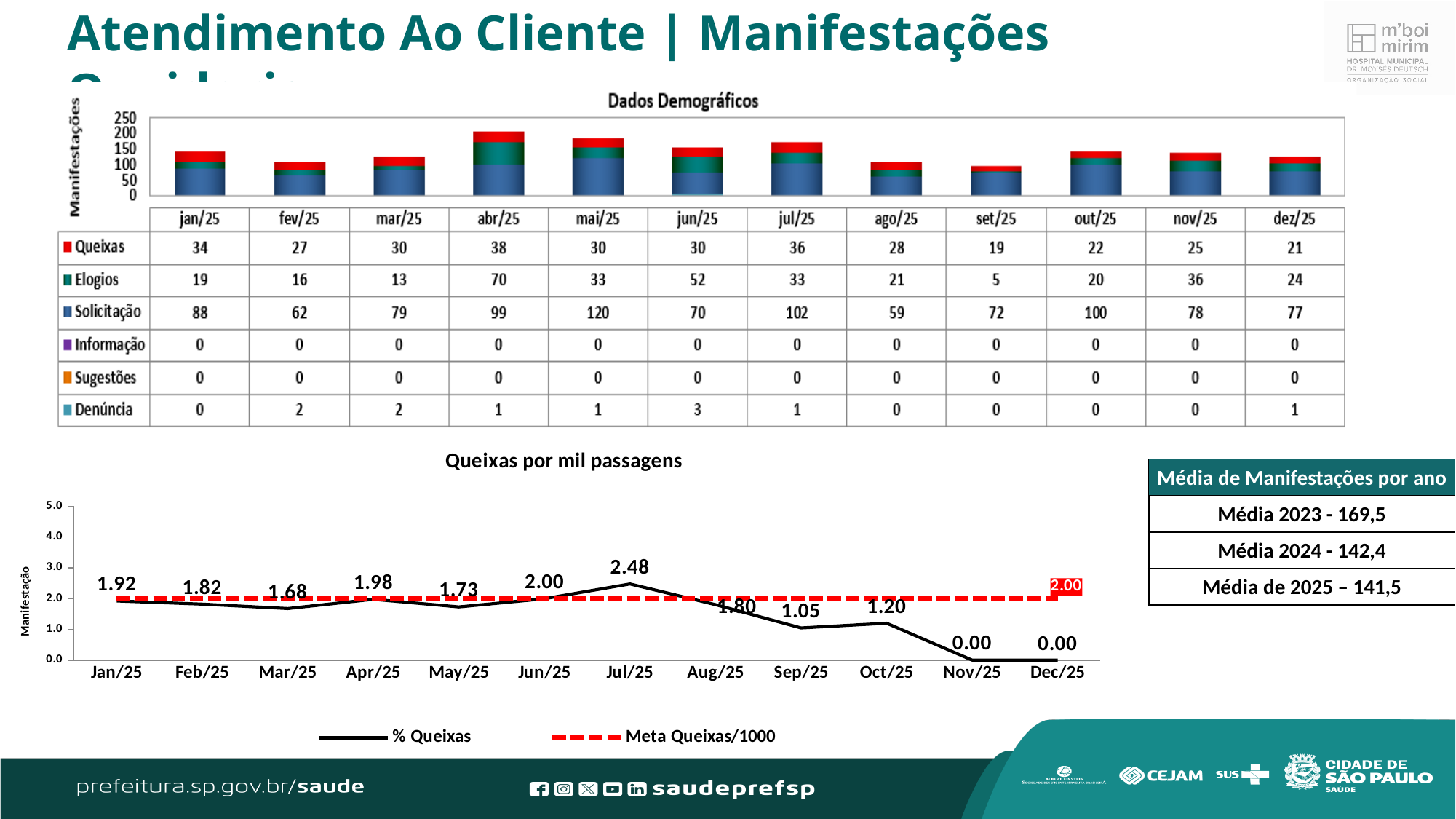
In the Queixas por mil passagens chart, is the % Queixas value for Sep/25 larger or smaller than the value for Jun/25? Smaller In the Queixas por mil passagens chart, what is the % Queixas value for Jul/25? 2.48 How many series does the legend of the Dados Demográficos chart list? 6 What kind of chart is Dados Demográficos? Stacked bar chart In the Dados Demográficos chart, which month has the highest Elogios value? abr/25 In the Dados Demográficos chart, what is the difference between the Solicitação values for mai/25 and ago/25? 61 In the Dados Demográficos chart, what is the Solicitação value for mai/25? 120 In the Dados Demográficos chart, what is the total of the stacked bar for abr/25? 208 In the Queixas por mil passagens chart, which month has the highest % Queixas value? Jul/25 In the Dados Demográficos chart, what is the Queixas value for abr/25? 38 In the Dados Demográficos chart, which month has the lowest Queixas value? set/25 In the Queixas por mil passagens chart, what is the difference between the % Queixas values for Jul/25 and Jan/25? 0.56